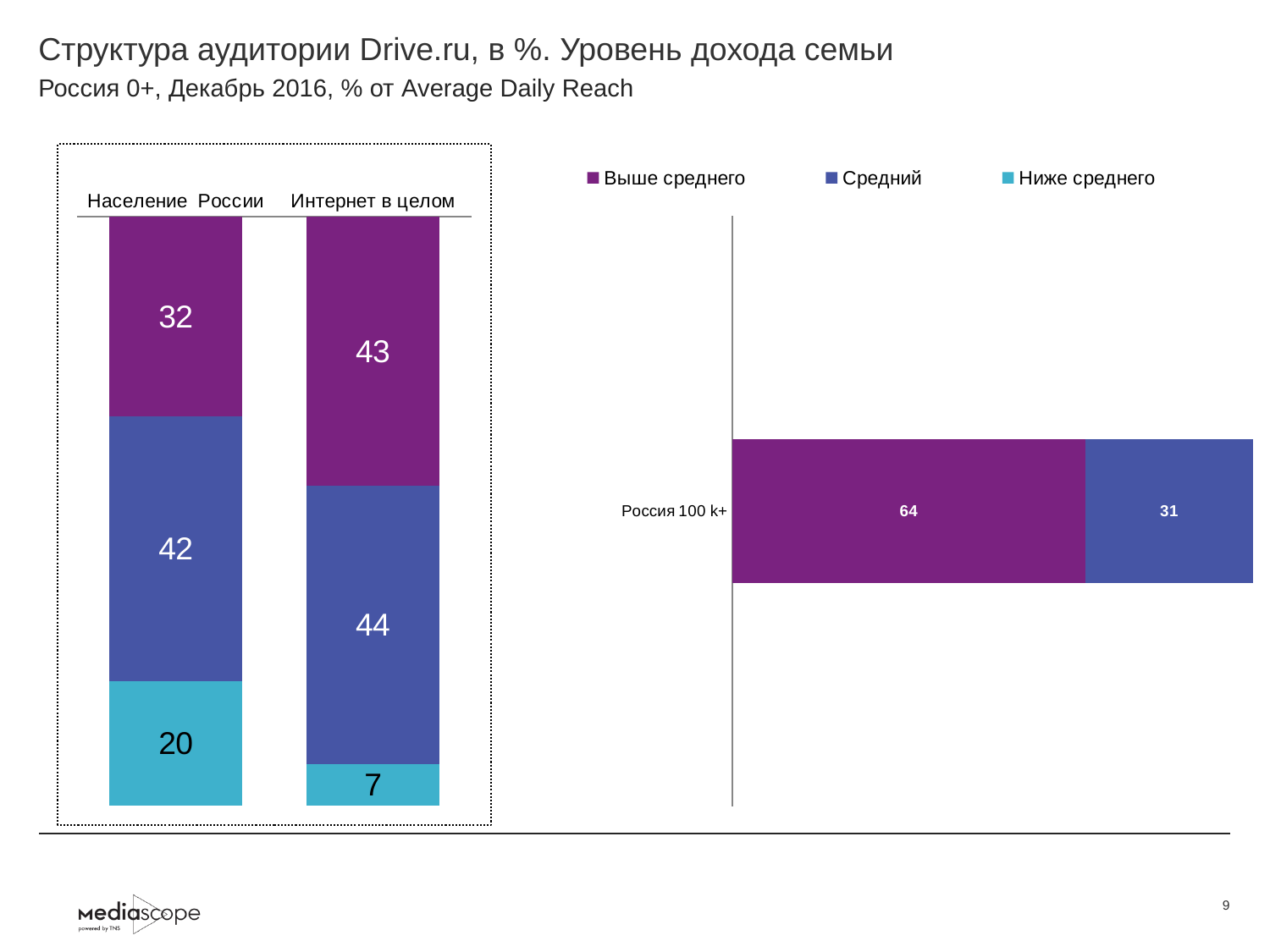
In the left chart, what is the value of the 'Выше среднего' segment for 'Население России'? 32 How many series does the legend list? 3 In the left chart, what is the difference between the 'Выше среднего' values for 'Интернет в целом' and 'Население России'? 11 How many categories are shown in the left chart? 2 In the left chart, what is the value of the 'Ниже среднего' segment for 'Интернет в целом'? 7 What type of chart is the right chart? Stacked bar chart In the right chart, what is the value of the 'Выше среднего' segment for 'Россия 100 k+'? 64 In the left chart, what is the value of the 'Средний' segment for 'Интернет в целом'? 44 In the left chart, which segment is the largest for 'Население России'? Средний In the left chart, which segment is the smallest for 'Интернет в целом'? Ниже среднего In the left chart, which category has the larger 'Ниже среднего' segment: 'Население России' or 'Интернет в целом'? Население России In the right chart, what is the value of the 'Средний' segment for 'Россия 100 k+'? 31